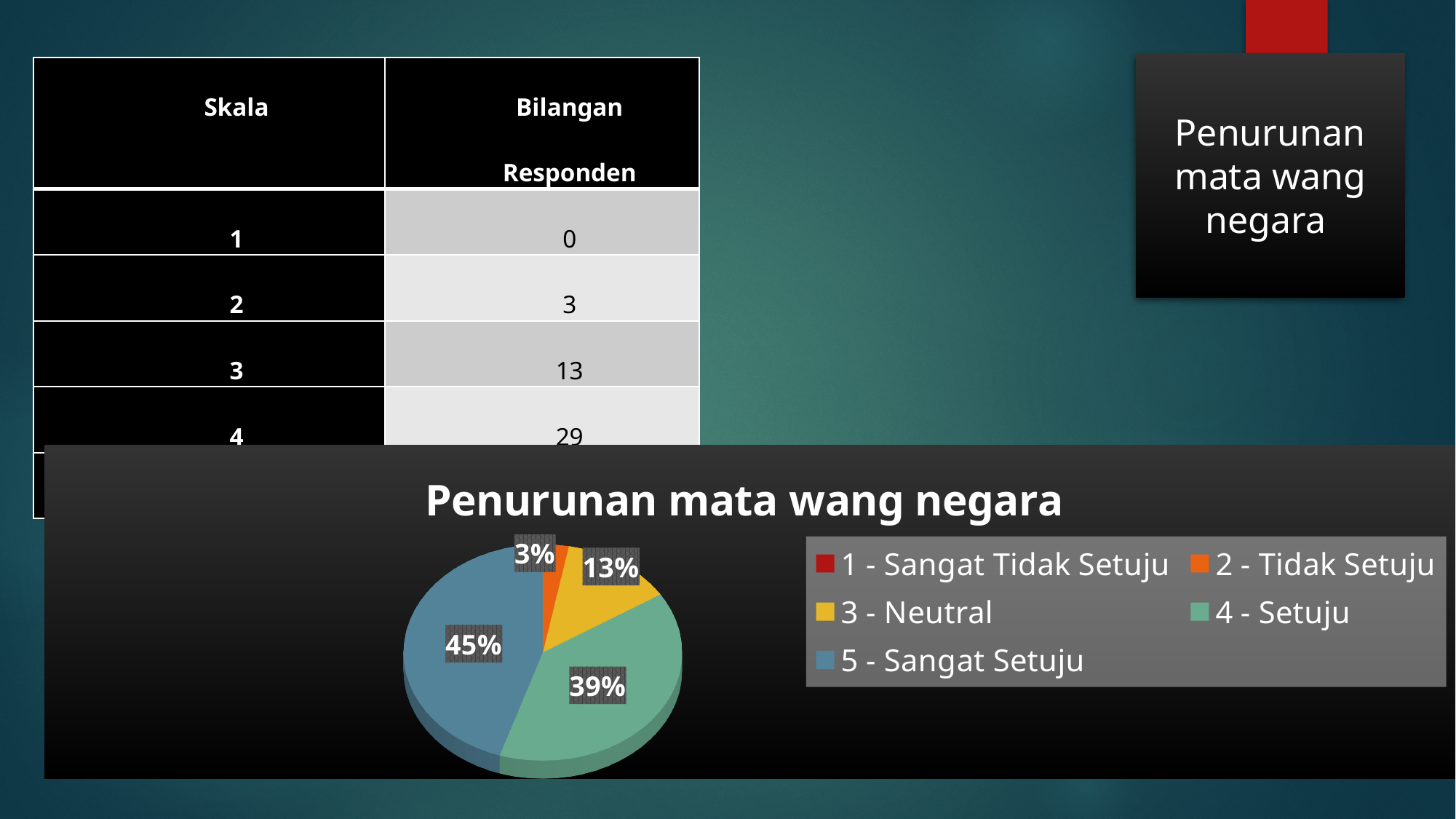
What is the difference in percentage points between the 5 - Sangat Setuju slice and the 4 - Setuju slice? 6% What percentage of the pie is labelled for 2 - Tidak Setuju? 3% Which category has the largest slice of the pie? 5 - Sangat Setuju What is the title of the chart? Penurunan mata wang negara What percentage of the pie is labelled for 4 - Setuju? 39% What type of chart is shown on the slide? pie chart What percentage of the pie is labelled for 3 - Neutral? 13% How many entries does the chart legend list? 5 Which slice is larger, 3 - Neutral or 4 - Setuju? 4 - Setuju What colour is used for the 5 - Sangat Setuju slice? blue What percentage of the pie is labelled for 5 - Sangat Setuju? 45% Which of the labelled slices is the smallest? 2 - Tidak Setuju